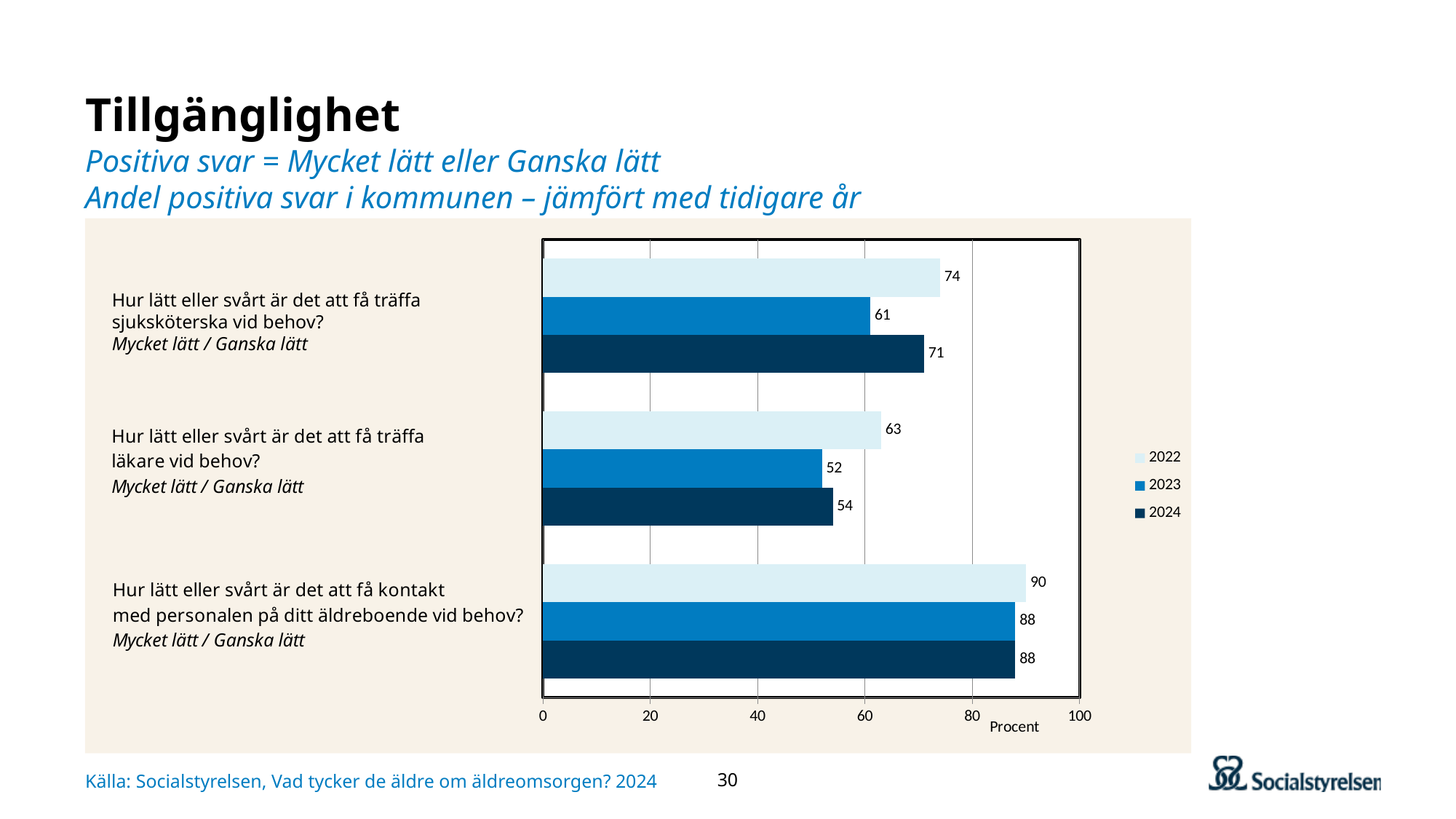
What is the difference between the 2022 and 2023 values for "Hur lätt eller svårt är det att få träffa sjuksköterska vid behov?"? 13 Which question has the lowest 2024 value? Hur lätt eller svårt är det att få träffa läkare vid behov? How many questions (categories) are shown in the chart? 3 What is the 2024 value for "Hur lätt eller svårt är det att få kontakt med personalen på ditt äldreboende vid behov?"? 88 Is the 2024 value for "Hur lätt eller svårt är det att få träffa sjuksköterska vid behov?" greater or less than 60? greater What is the 2022 value for "Hur lätt eller svårt är det att få träffa sjuksköterska vid behov?"? 74 What is the label of the x axis? Procent What kind of chart is shown on the slide? Bar chart How many series does the legend list? 3 Which is larger for "Hur lätt eller svårt är det att få träffa läkare vid behov?": the 2022 value or the 2024 value? 2022 Which question has the highest 2022 value? Hur lätt eller svårt är det att få kontakt med personalen på ditt äldreboende vid behov? What is the 2023 value for "Hur lätt eller svårt är det att få träffa läkare vid behov?"? 52